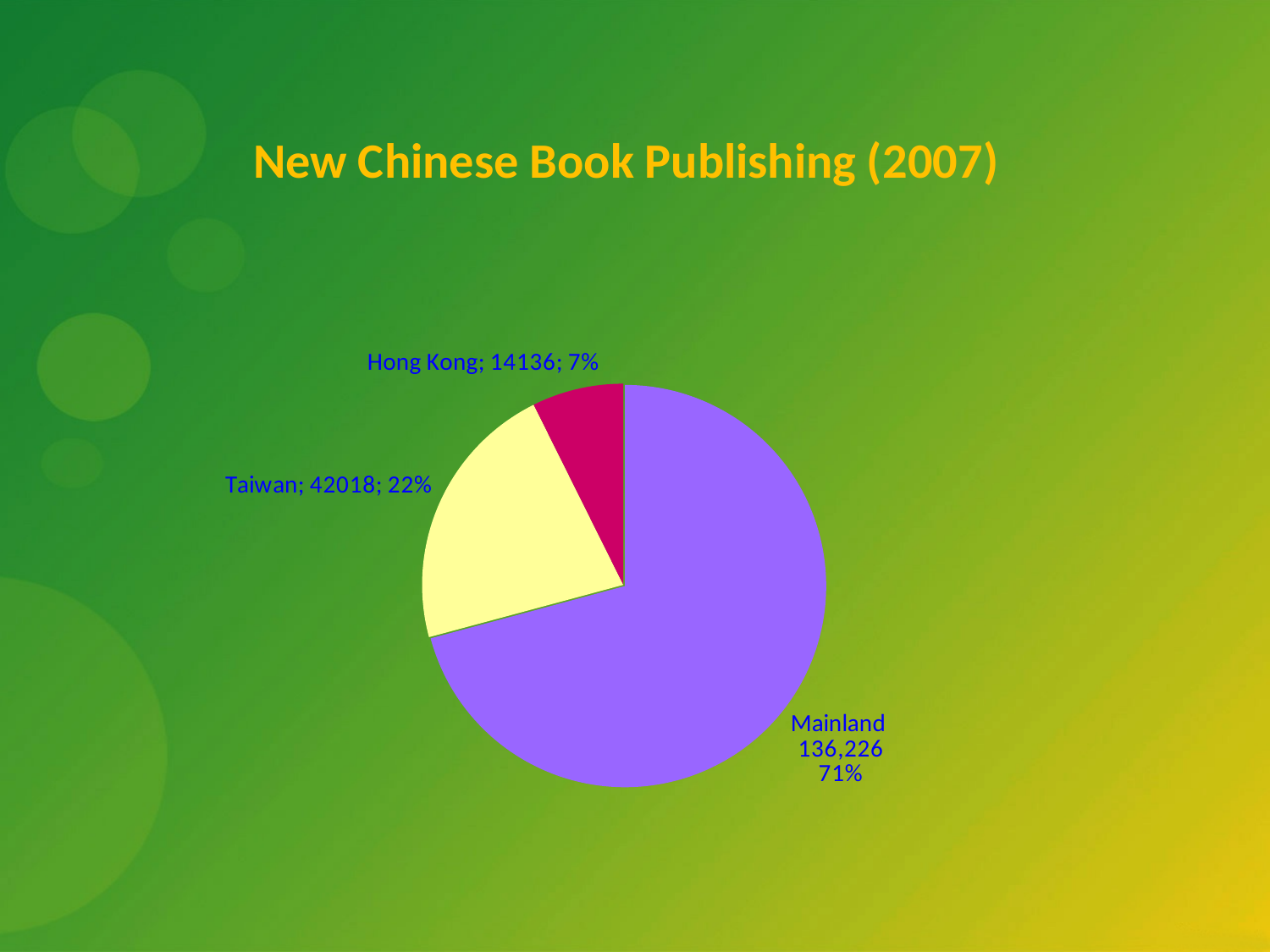
Which region has the smallest slice of the pie? Hong Kong What share of the pie does Taiwan account for? 22% What share of the pie does Hong Kong account for? 7% What kind of chart is shown on the slide? pie chart What is the value shown for Taiwan? 42018 Which is larger, the value for Taiwan or the value for Hong Kong? Taiwan What is the value shown for Mainland? 136,226 What is the title of the chart? New Chinese Book Publishing (2007) Which region has the largest slice of the pie? Mainland What is the difference between the values for Taiwan and Hong Kong? 27882 What is the value shown for Hong Kong? 14136 How many slices does the pie chart have? 3